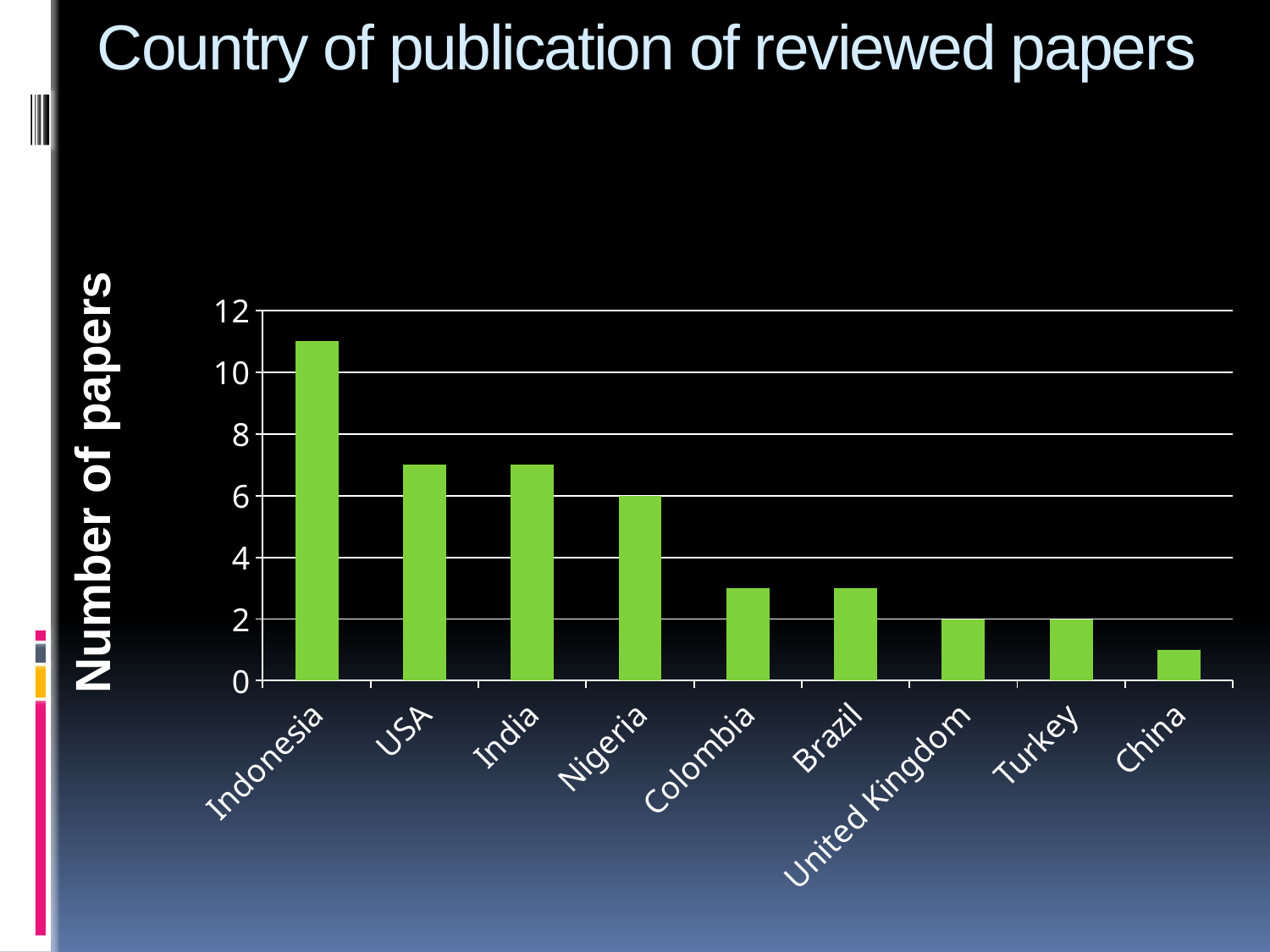
What kind of chart is shown on the slide? bar chart Which country has the highest number of papers? Indonesia Do the values rise or fall moving from left to right along the x axis? fall Is the value for Colombia greater or less than 4? less What is the number of papers for Turkey? 2 Which country has the lowest number of papers? China Is the value for Indonesia greater or less than 10? greater What is the number of papers for Nigeria? 6 What is the number of papers for United Kingdom? 2 What is the label on the vertical axis of the chart? Number of papers How many countries are shown on the x axis of the chart? 9 Which has more papers, Indonesia or USA? Indonesia